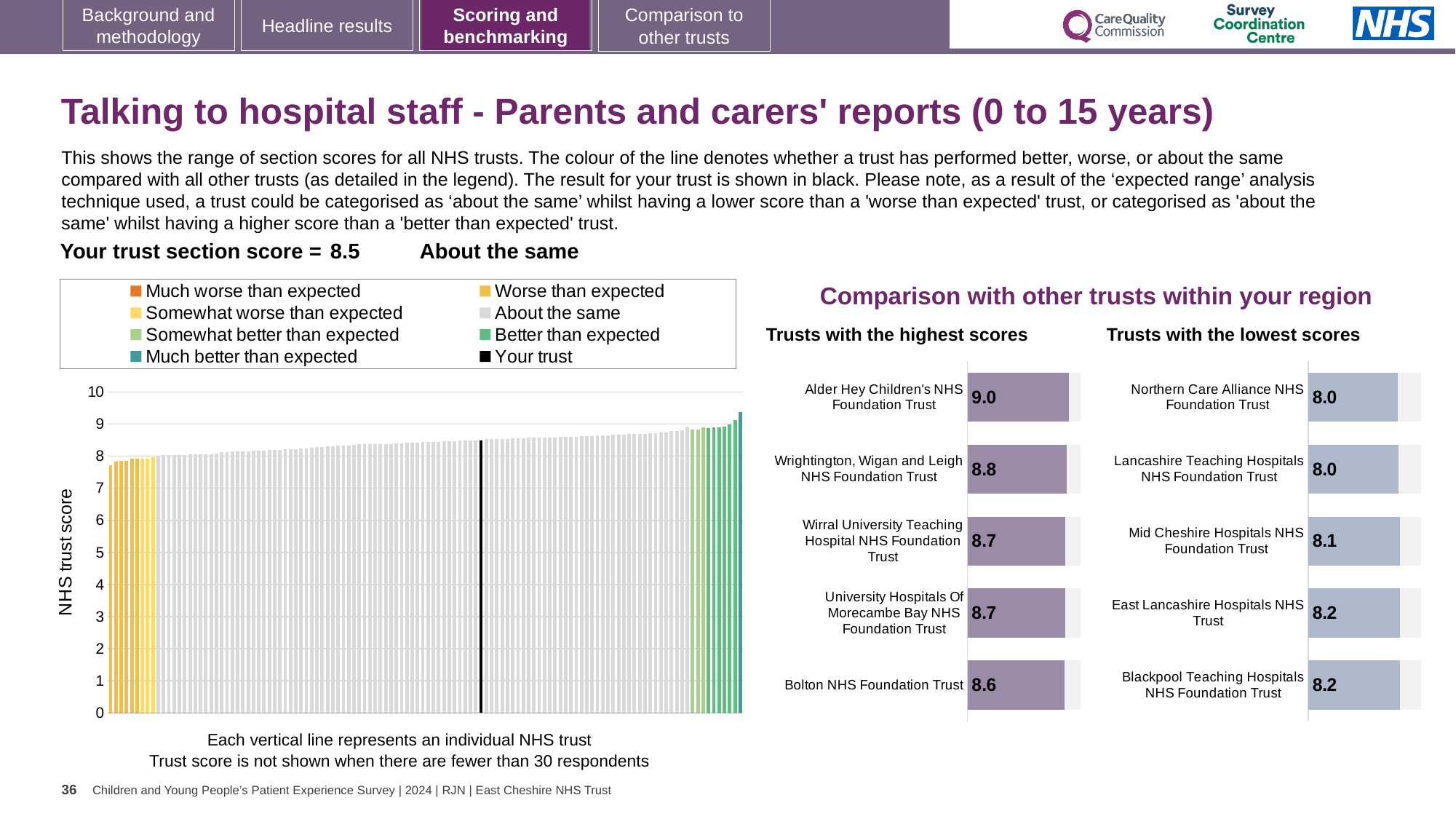
In the 'Trusts with the lowest scores' chart, what is the difference between the scores of Blackpool Teaching Hospitals NHS Foundation Trust and Northern Care Alliance NHS Foundation Trust? 0.2 In the 'Trusts with the highest scores' chart, what is the score for Bolton NHS Foundation Trust? 8.6 What kind of chart is the large 'NHS trust score' chart on the left of the slide? Bar chart How many entries does the legend of the left-hand 'NHS trust score' chart list? 8 In the 'Trusts with the highest scores' chart, which trust has the highest score? Alder Hey Children's NHS Foundation Trust In the 'Trusts with the lowest scores' chart, what is the score for Mid Cheshire Hospitals NHS Foundation Trust? 8.1 Which has the larger score: Wrightington, Wigan and Leigh NHS Foundation Trust in the highest scores chart, or East Lancashire Hospitals NHS Trust in the lowest scores chart? Wrightington, Wigan and Leigh NHS Foundation Trust In the left-hand 'NHS trust score' chart, do the bar values rise or fall from left to right? rise In the 'Trusts with the highest scores' chart, how much higher is Alder Hey Children's NHS Foundation Trust's score than Bolton NHS Foundation Trust's score? 0.4 How many trusts are listed in the 'Trusts with the highest scores' chart? 5 In the 'Trusts with the highest scores' chart, what is the score for Alder Hey Children's NHS Foundation Trust? 9.0 In the left-hand 'NHS trust score' chart, are the green bars at the right-hand end greater or less than 8? greater